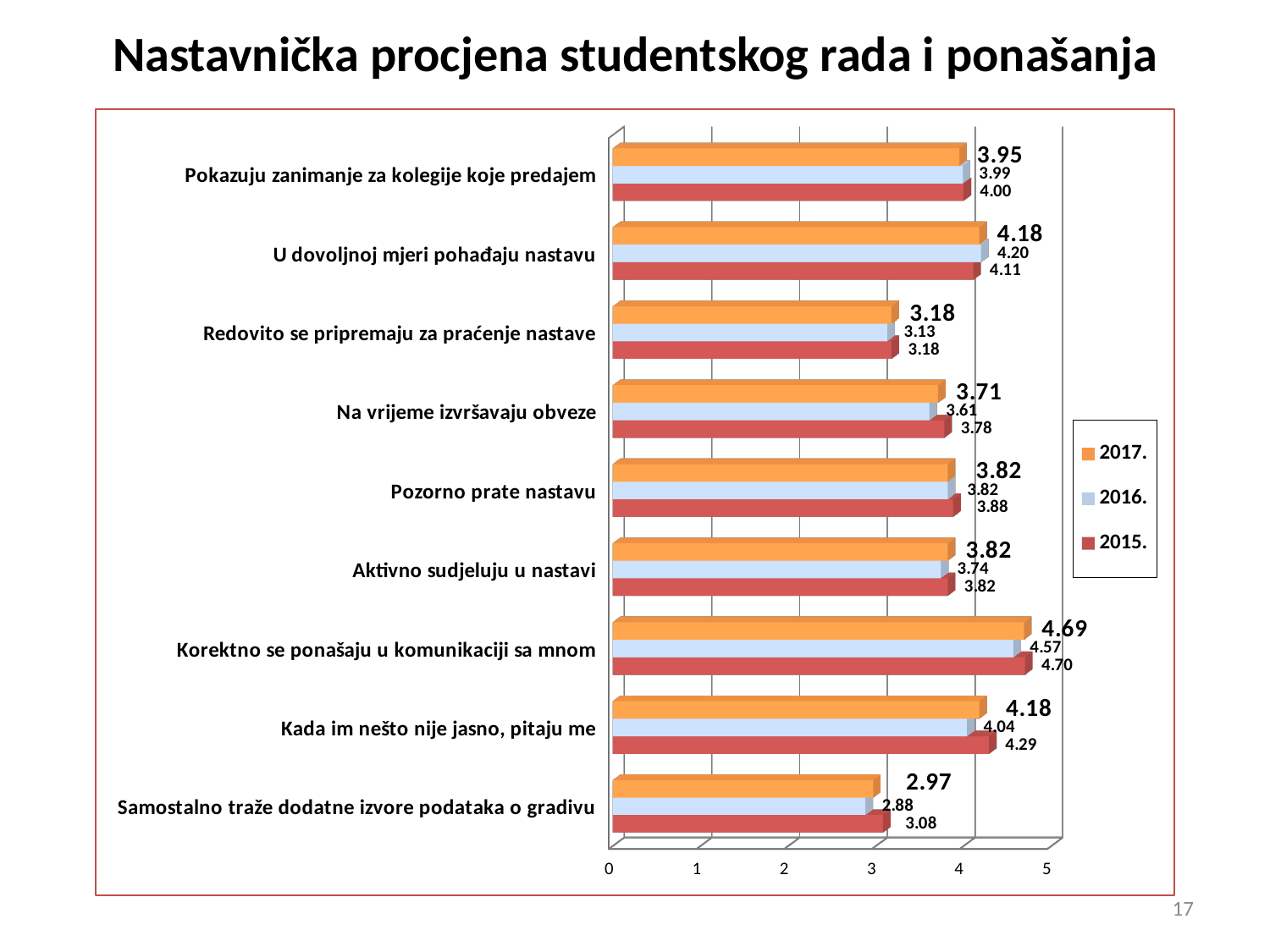
What kind of chart is shown on the slide? Bar chart How many categories are shown on the chart? 9 What is the 2017. value for "Korektno se ponašaju u komunikaciji sa mnom"? 4.69 What is the 2016. value for "Na vrijeme izvršavaju obveze"? 3.61 Is the 2017. value for "U dovoljnoj mjeri pohađaju nastavu" greater or less than 4? greater Which category has the lowest 2016. value? Samostalno traže dodatne izvore podataka o gradivu Which category has the highest 2017. value? Korektno se ponašaju u komunikaciji sa mnom For "Redovito se pripremaju za praćenje nastave", which is larger: the 2017. value or the 2016. value? 2017. Which series is shown in orange in the legend? 2017. What is the 2015. value for "Samostalno traže dodatne izvore podataka o gradivu"? 3.08 How many series does the legend list? 3 What is the difference between the 2015. and 2016. values for "Kada im nešto nije jasno, pitaju me"? 0.25